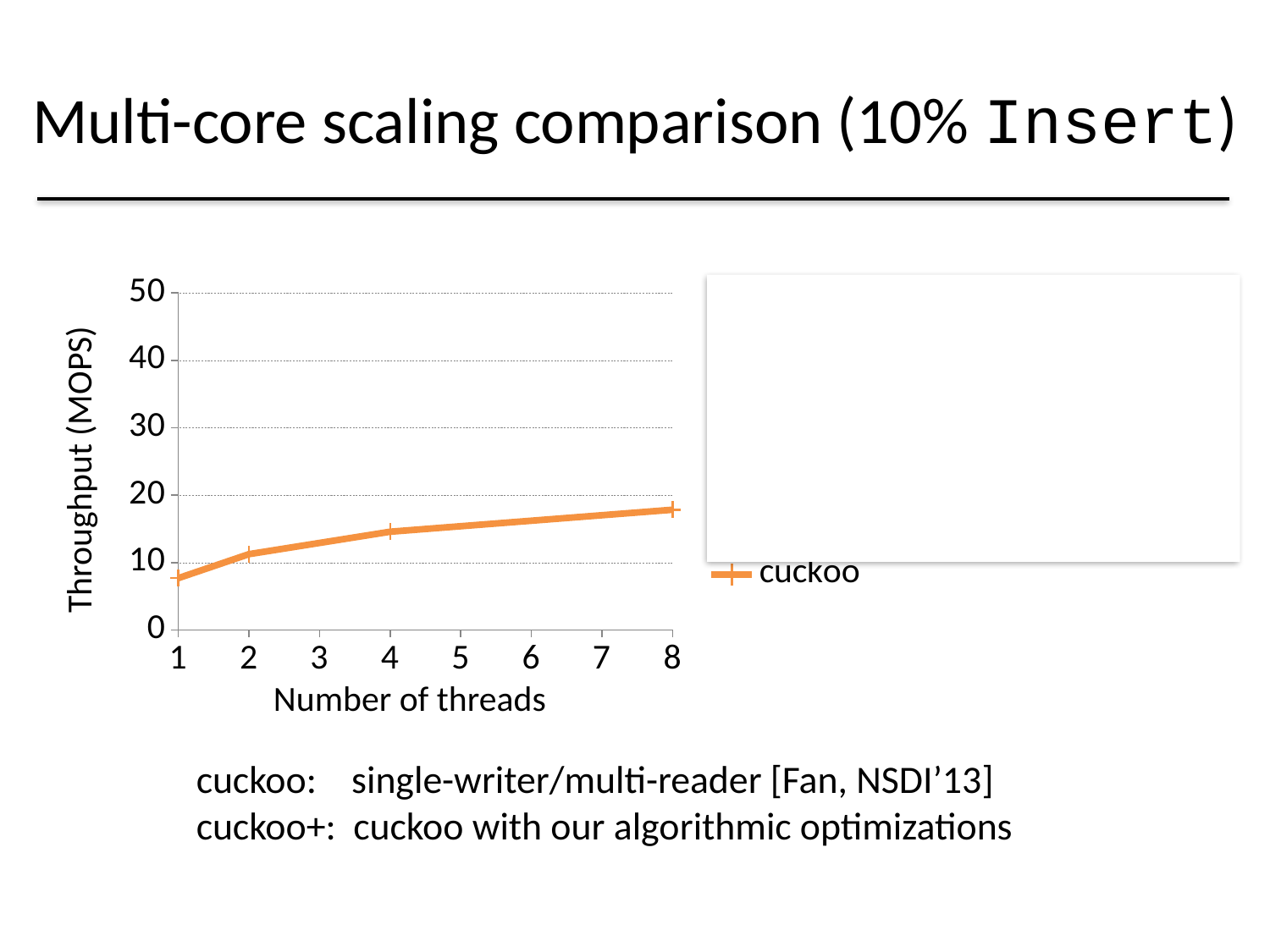
What is the label of the y axis? Throughput (MOPS) Which has the higher cuckoo throughput, 2 threads or 8 threads? 8 threads How many data points are plotted for the cuckoo series? 4 At which number of threads is the cuckoo throughput highest? 8 Is the cuckoo throughput at 8 threads greater or less than 10? greater Is the cuckoo throughput at 4 threads greater or less than 10? greater Is the cuckoo throughput at 8 threads greater or less than 20? less What kind of chart is shown on the slide? line chart Does the throughput of cuckoo rise or fall as the number of threads increases? rise What is the title of the slide's chart? Multi-core scaling comparison (10% Insert) At which number of threads is the cuckoo throughput lowest? 1